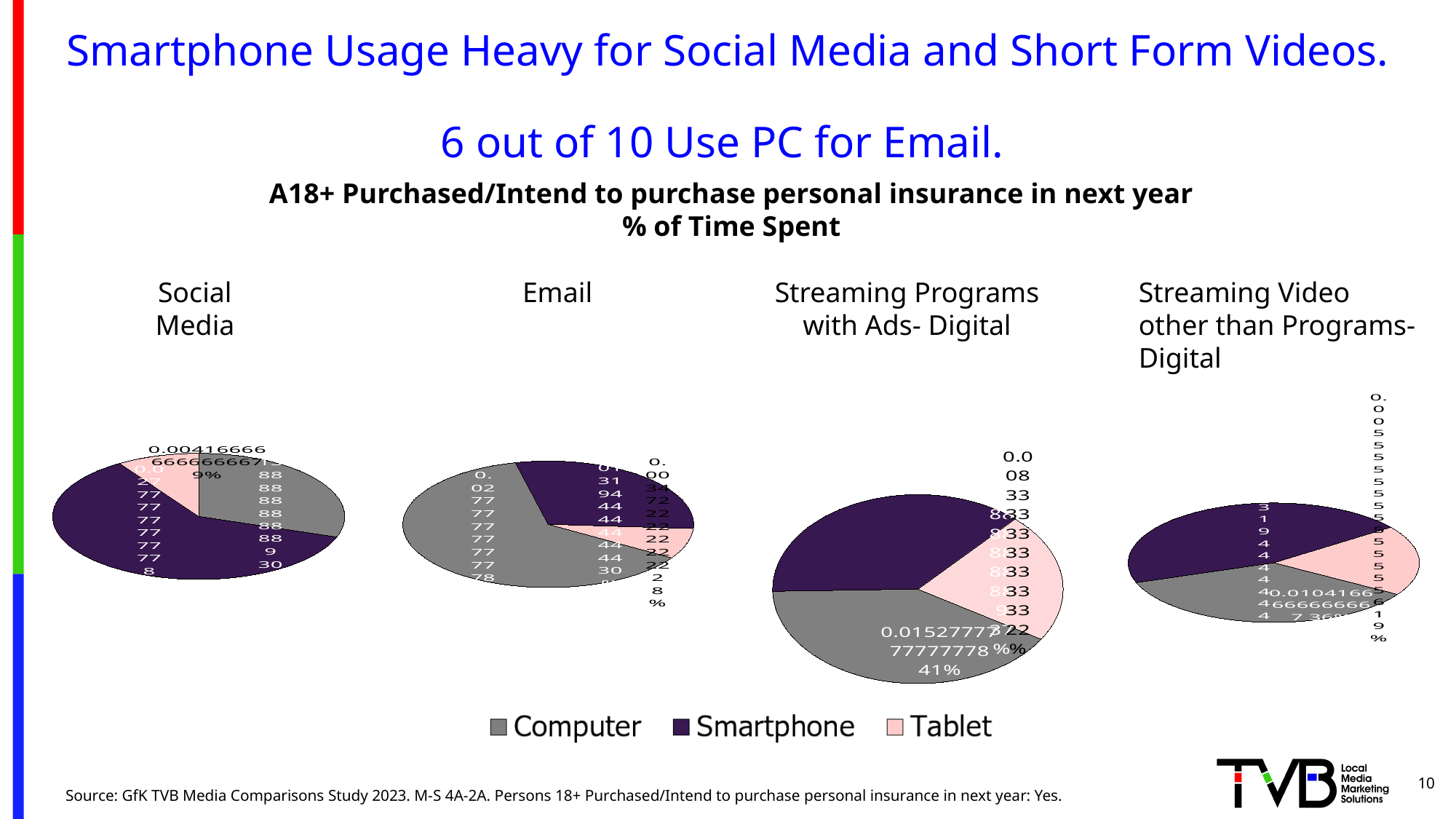
In the Streaming Video other than Programs- Digital pie chart, which is larger, the Smartphone share or the Tablet share? Smartphone In the Social Media pie chart, what share of time spent is on Tablet? 9% In the Email pie chart, which device has the smallest share? Tablet How many series does the legend list? 3 In the Streaming Programs with Ads- Digital pie chart, what share of time spent is on Computer? 41% How many pie charts are shown on the slide? 4 In the Email pie chart, which device has the largest share? Computer In the Streaming Programs with Ads- Digital pie chart, which device has the largest share? Computer In the Social Media pie chart, which device has the largest share? Smartphone In the Streaming Video other than Programs- Digital pie chart, which device has the smallest share? Tablet Which colour represents Tablet in the legend? pink What kind of chart is used for the Social Media data on this slide? pie chart